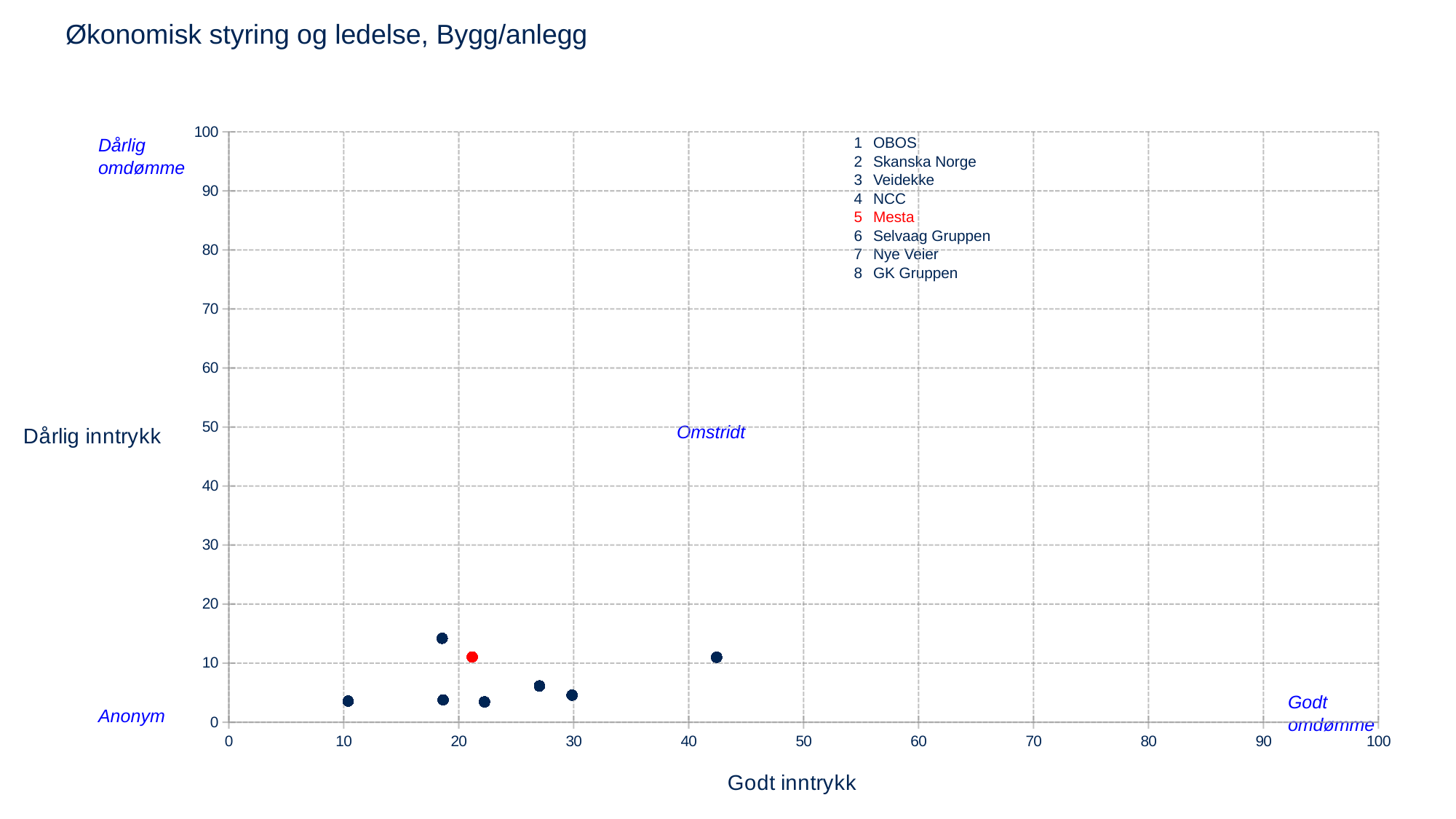
Is the y-axis value of the highest point greater or less than 20? less Is the x-axis value (Godt inntrykk) of the red point greater or less than 30? less How many companies are listed in the legend? 8 How many data points are plotted on the chart? 8 How many points have an x-axis value greater than 40? 1 Is the x-axis value of the rightmost point greater or less than 40? greater What is the label of the x axis? Godt inntrykk What is the title of the chart? Økonomisk styring og ledelse, Bygg/anlegg Which company is highlighted in red in the legend? Mesta What kind of chart is shown on the slide? scatter chart